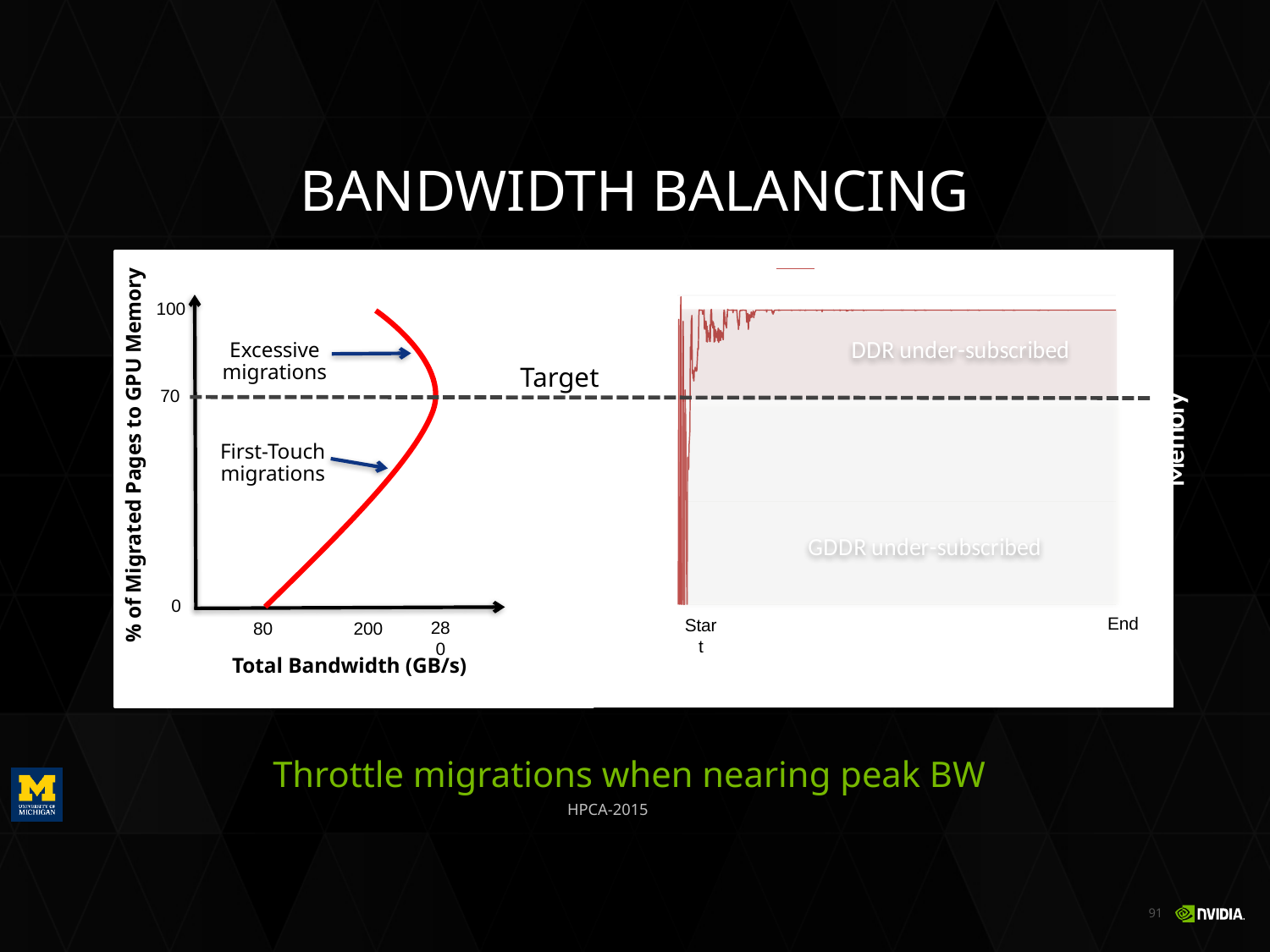
In the left chart, what is the highest tick value shown on the Total Bandwidth axis? 280 In the right chart, does the plotted line rise or fall immediately after Start? rises In the left chart, which label points to the part of the curve below the Target line? First-Touch migrations How many tick values are labelled on the vertical axis of the left chart? 3 In the right chart, which region is labelled below the Target line? GDDR under-subscribed In the left chart, which label points to the part of the curve above the Target line? Excessive migrations What kind of chart is the left chart with the red curve? line chart In the left chart, is the total bandwidth at the Target level (70%) greater or less than 200 GB/s? greater In the left chart, at what percentage of migrated pages is the dashed Target line drawn? 70 In the right chart, which region is labelled above the Target line? DDR under-subscribed In the left chart, what is the lowest tick value shown on the Total Bandwidth axis? 80 In the left chart, is the total bandwidth at 0% migrated pages greater or less than 200 GB/s? less